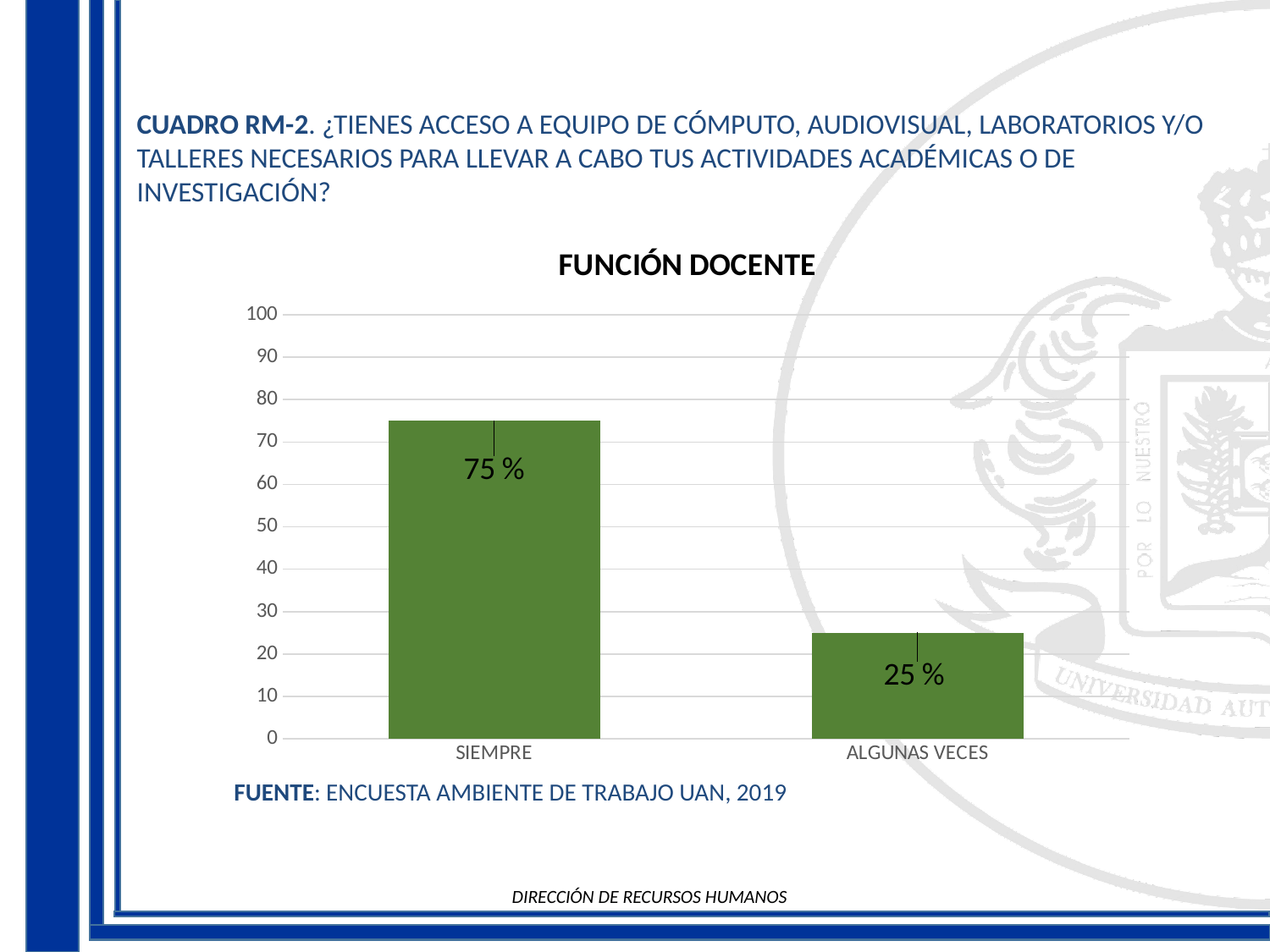
What kind of chart is shown on the slide? bar chart What is the value for ALGUNAS VECES? 25 % Which category has the highest value? SIEMPRE What is the value for SIEMPRE? 75 % Is the value for SIEMPRE greater or less than 50? greater What is the maximum value shown on the y axis? 100 What is the title of the chart? FUNCIÓN DOCENTE Is the value for ALGUNAS VECES greater or less than 30? less Which is larger, the value for SIEMPRE or the value for ALGUNAS VECES? SIEMPRE Which category has the lowest value? ALGUNAS VECES What is the difference between the values for SIEMPRE and ALGUNAS VECES? 50 % How many categories are shown on the x axis? 2